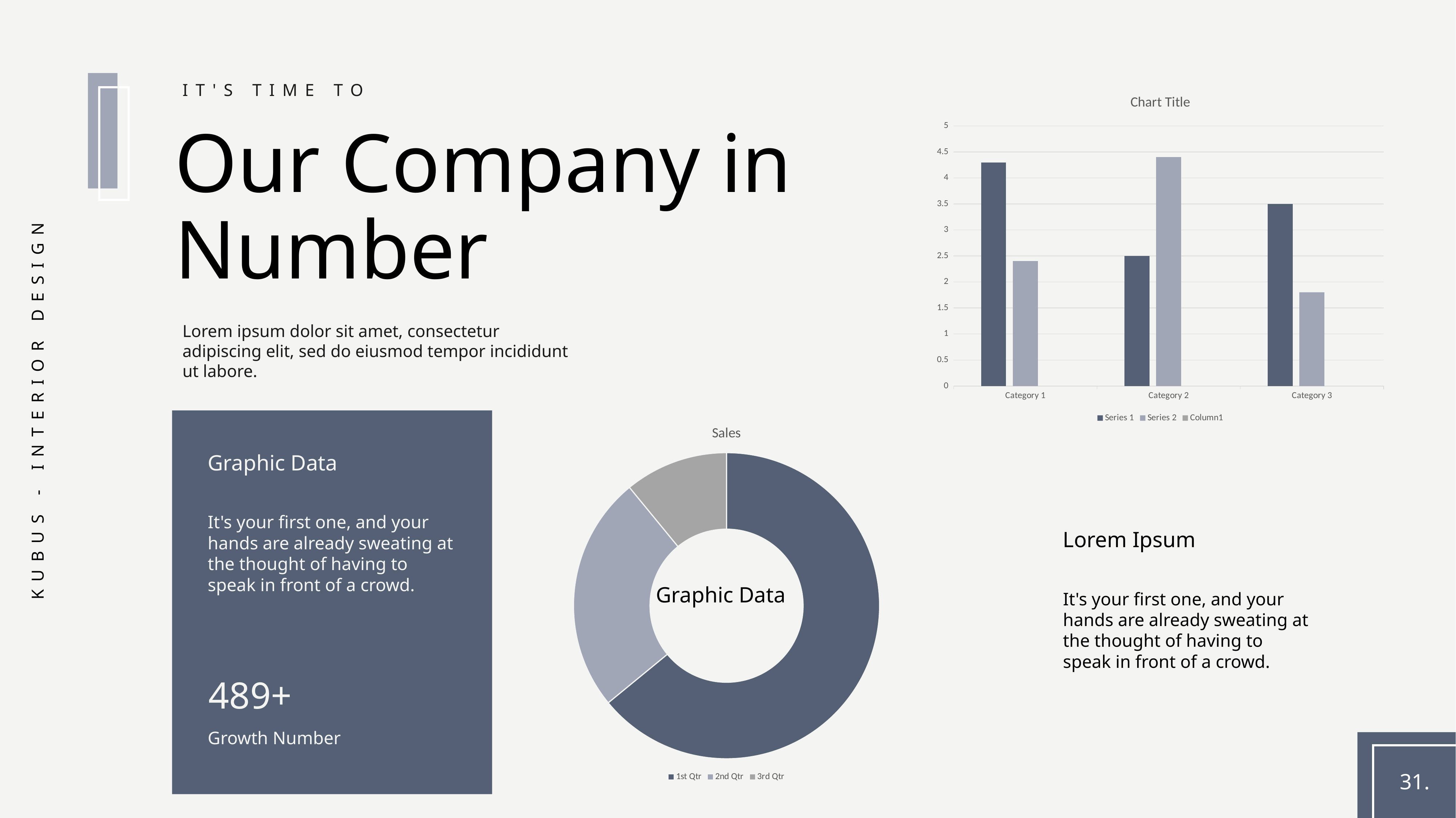
In the chart titled "Chart Title", is the Series 2 value for Category 3 greater or less than 2? less In the chart titled "Chart Title", which category has the lowest value for Series 2? Category 3 In the chart titled "Sales", how many slices are there? 3 In the chart titled "Chart Title", how many series does the legend list? 3 In the chart titled "Chart Title", which category has the highest value for Series 2? Category 2 What kind of chart is the chart titled "Sales"? doughnut chart In the chart titled "Chart Title", is the Series 2 value for Category 2 greater or less than 4? greater What kind of chart is the chart titled "Chart Title"? bar chart In the chart titled "Chart Title", which category has the highest value for Series 1? Category 1 In the chart titled "Chart Title", for Category 1, which is larger: Series 1 or Series 2? Series 1 In the chart titled "Chart Title", how many categories are shown on the x axis? 3 In the chart titled "Sales", which quarter has the largest slice? 1st Qtr